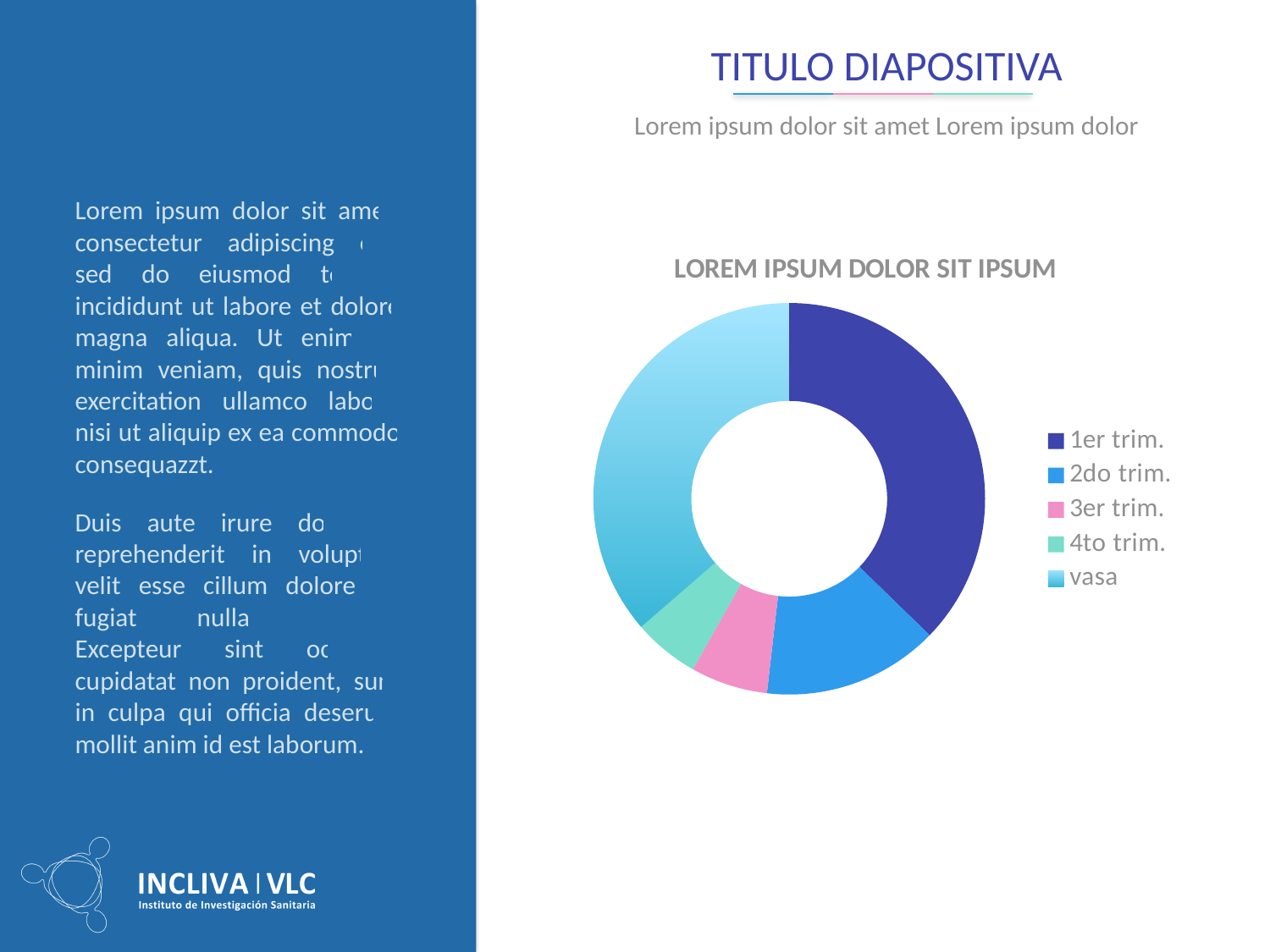
Which slice is larger, 2do trim. or 3er trim.? 2do trim. How many slices does the doughnut chart have? 5 Which slice is larger, 1er trim. or 2do trim.? 1er trim. What is the last entry listed in the chart legend? vasa What is the title of the chart? LOREM IPSUM DOLOR SIT IPSUM Which slice is larger, vasa or 4to trim.? vasa How many entries does the chart legend list? 5 What kind of chart is shown on the slide? Doughnut chart